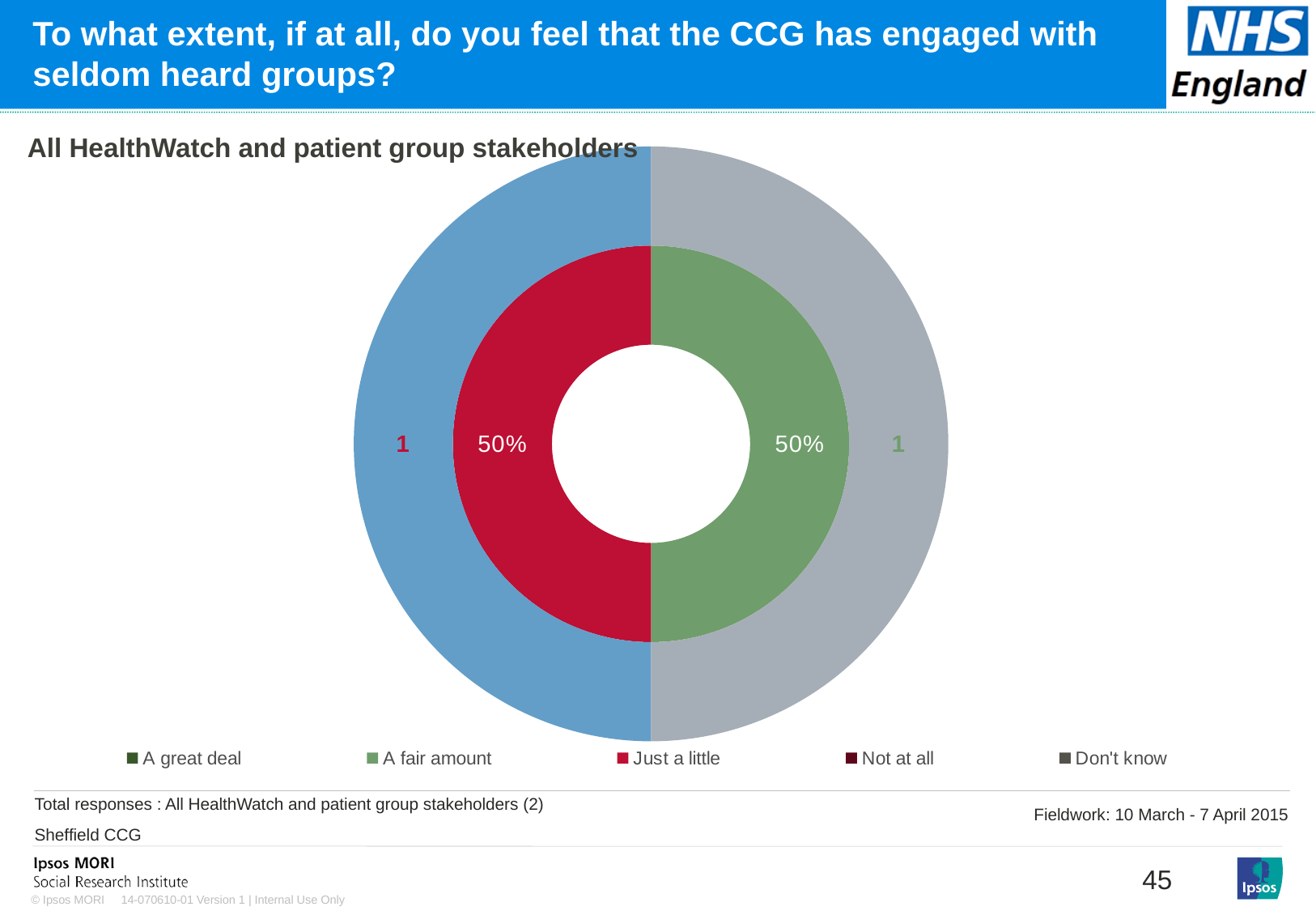
What is the title shown above the chart? All HealthWatch and patient group stakeholders How many responses does the outer ring show for 'A fair amount'? 1 Which is larger, the share for 'A fair amount' or the share for 'Just a little', or are they equal? They are equal What is the total number of responses stated for All HealthWatch and patient group stakeholders? 2 What do the two percentages shown in the inner ring add up to? 100% What percentage of respondents said 'A fair amount'? 50% What percentage of respondents said 'Just a little'? 50% What type of chart is shown on the slide? Doughnut (pie) chart How many response categories have a percentage shown in the inner ring? 2 What is the difference between the percentages for 'A fair amount' and 'Just a little'? 0% How many entries does the chart legend list? 5 How many responses does the outer ring show for 'Just a little'? 1